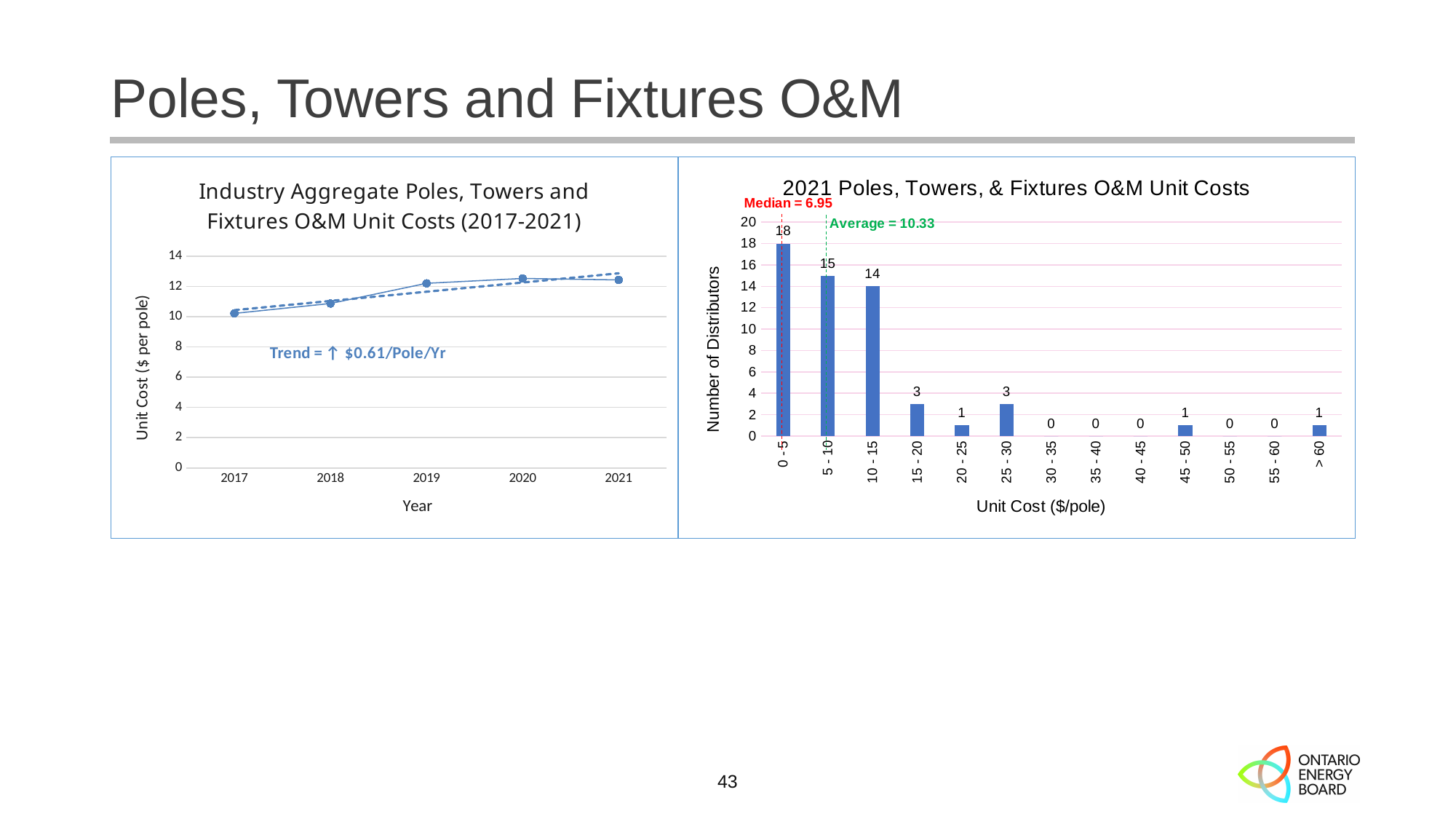
In the chart titled "2021 Poles, Towers, & Fixtures O&M Unit Costs", what average value is annotated? 10.33 What kind of chart is the left-hand chart titled "Industry Aggregate Poles, Towers and Fixtures O&M Unit Costs (2017-2021)"? line chart In the left-hand chart titled "Industry Aggregate Poles, Towers and Fixtures O&M Unit Costs (2017-2021)", do the unit costs generally rise or fall from 2017 to 2021? rise In the chart titled "2021 Poles, Towers, & Fixtures O&M Unit Costs", how many unit cost bins are shown on the x axis? 13 In the chart titled "2021 Poles, Towers, & Fixtures O&M Unit Costs", which unit cost bin has the most distributors? 0 - 5 In the chart titled "2021 Poles, Towers, & Fixtures O&M Unit Costs", what is the difference in number of distributors between the 0 - 5 bin and the 5 - 10 bin? 3 In the chart titled "2021 Poles, Towers, & Fixtures O&M Unit Costs", how many distributors are in the 25 - 30 bin? 3 In the chart titled "2021 Poles, Towers, & Fixtures O&M Unit Costs", what median value is annotated? 6.95 In the chart titled "2021 Poles, Towers, & Fixtures O&M Unit Costs", how many distributors are in the 0 - 5 unit cost bin? 18 In the chart titled "2021 Poles, Towers, & Fixtures O&M Unit Costs", how many distributors are in the 10 - 15 bin? 14 In the left-hand chart titled "Industry Aggregate Poles, Towers and Fixtures O&M Unit Costs (2017-2021)", is the unit cost for 2017 greater or less than 12? less In the chart titled "2021 Poles, Towers, & Fixtures O&M Unit Costs", which has more distributors, the 15 - 20 bin or the 20 - 25 bin? 15 - 20